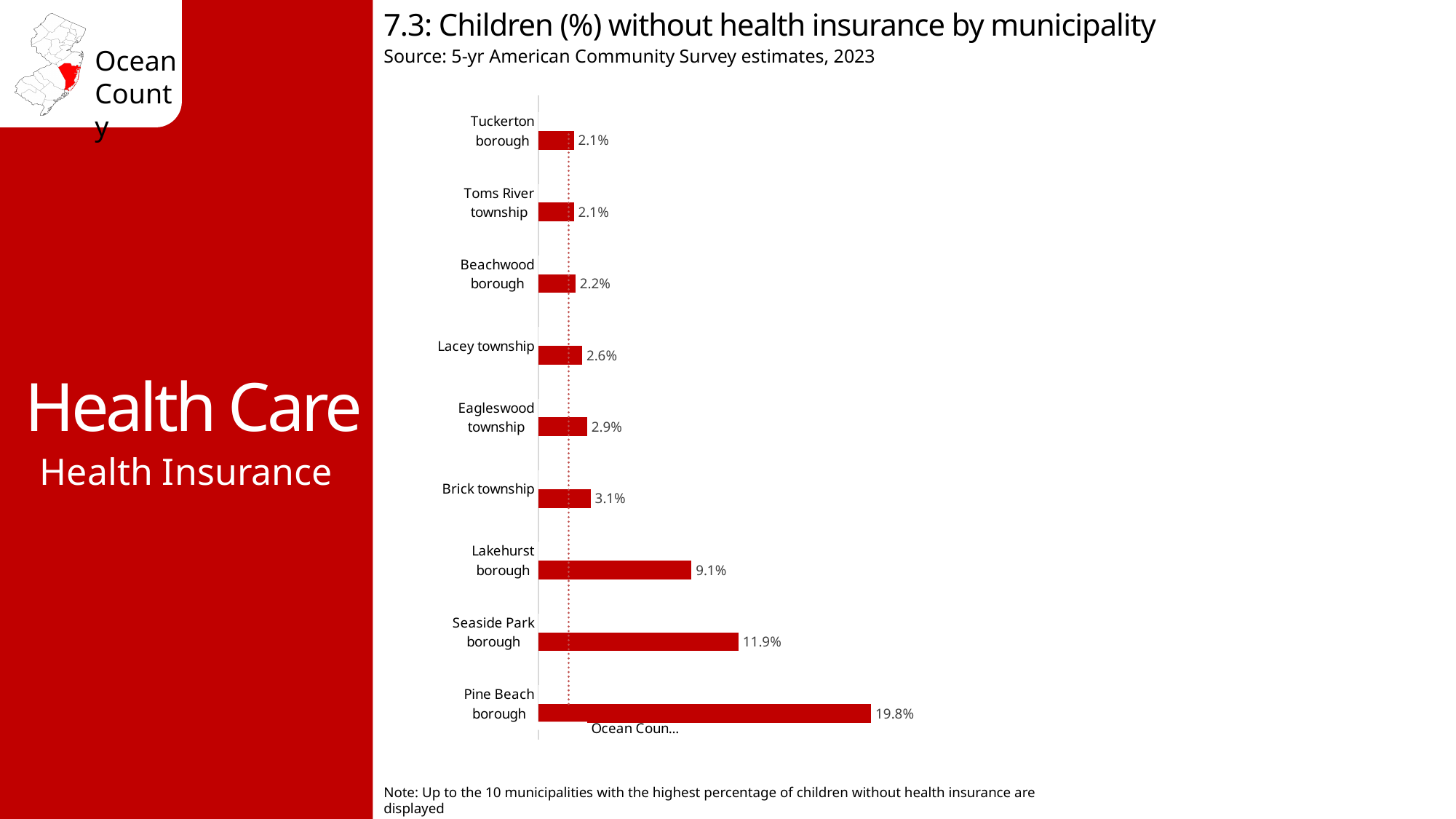
What is the value shown for Lakehurst borough? 9.1% Which has a higher value, Lacey township or Beachwood borough? Lacey township What is the value for Eagleswood township? 2.9% What percentage of children in Pine Beach borough are without health insurance? 19.8% What percentage is shown for Brick township? 3.1% Which has a higher value, Seaside Park borough or Lakehurst borough? Seaside Park borough What type of chart is used on this slide? Bar chart Which municipality has the highest percentage of children without health insurance? Pine Beach borough How many municipalities are shown in the chart? 9 What is the difference between the values for Lakehurst borough and Brick township? 6.0% What is the title of the chart? 7.3: Children (%) without health insurance by municipality What is the difference between the values for Pine Beach borough and Seaside Park borough? 7.9%